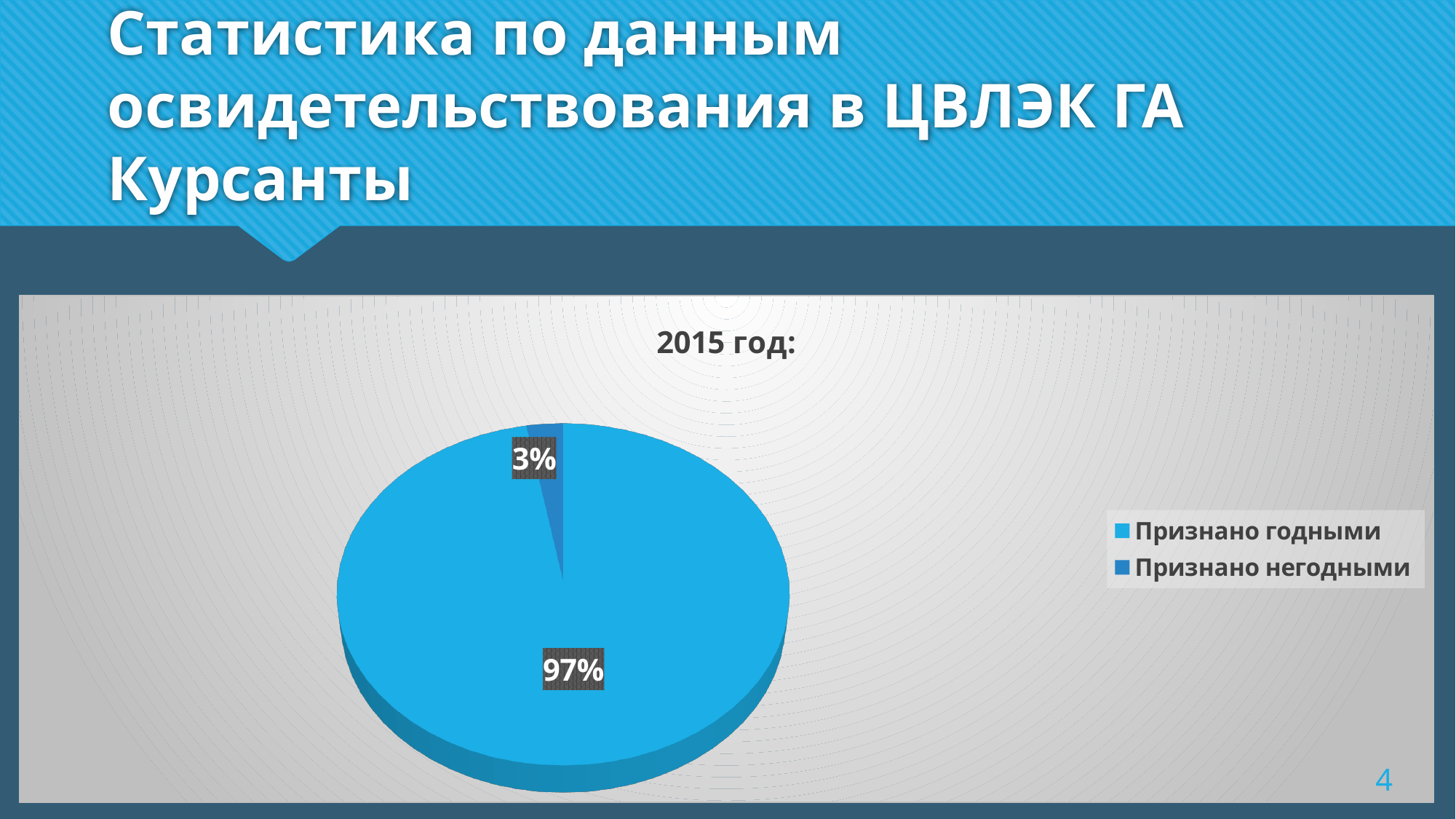
Which category has the smallest slice of the pie? Признано негодными What is the total of the two percentages shown on the pie? 100% What share of the pie is labelled "Признано негодными"? 3% What is the difference in percentage points between "Признано годными" and "Признано негодными"? 94 What kind of chart is shown on the slide? Pie chart How many slices does the pie chart have? 2 What share of the pie is labelled "Признано годными"? 97% Which legend entry is shown in the darker blue colour? Признано негодными What is the title of the chart? 2015 год: Which is larger: the share for "Признано годными" or for "Признано негодными"? Признано годными Which category has the largest slice of the pie? Признано годными How many entries does the legend list? 2